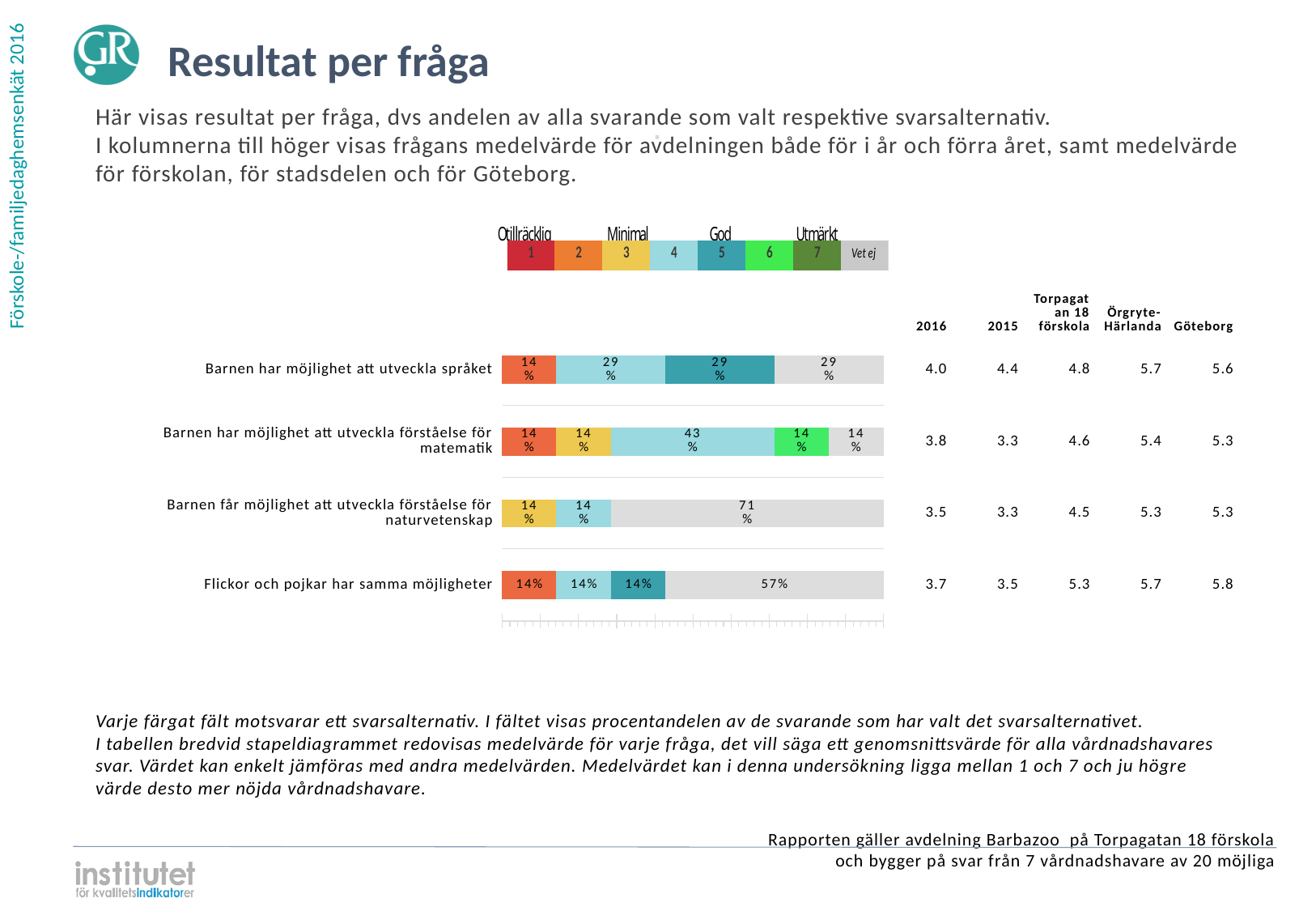
For "Barnen har möjlighet att utveckla förståelse för matematik", which is higher: the 2016 mean or the 2015 mean? 2016 What are the four scale labels shown above the colour legend? Otillräcklig, Minimal, God, Utmärkt What is the Göteborg mean value for "Flickor och pojkar har samma möjligheter"? 5.8 What percentage is shown for the grey "Vet ej" segment of "Flickor och pojkar har samma möjligheter"? 57% What kind of chart is used to show the results per question on this slide? bar chart How many percentage points larger is the "Vet ej" share for the naturvetenskap question (71%) than for "Flickor och pojkar har samma möjligheter" (57%)? 14 Which question has the lowest 2016 mean value? Barnen får möjlighet att utveckla förståelse för naturvetenskap What is the largest segment value in the bar for "Barnen har möjlighet att utveckla förståelse för matematik"? 43% How many questions (categories) are shown as bars in the chart? 4 What percentage of respondents answered "Vet ej" (grey segment) for "Barnen får möjlighet att utveckla förståelse för naturvetenskap"? 71% What is the 2016 mean value for "Barnen har möjlighet att utveckla språket"? 4.0 Which question has the largest "Vet ej" (grey) share? Barnen får möjlighet att utveckla förståelse för naturvetenskap